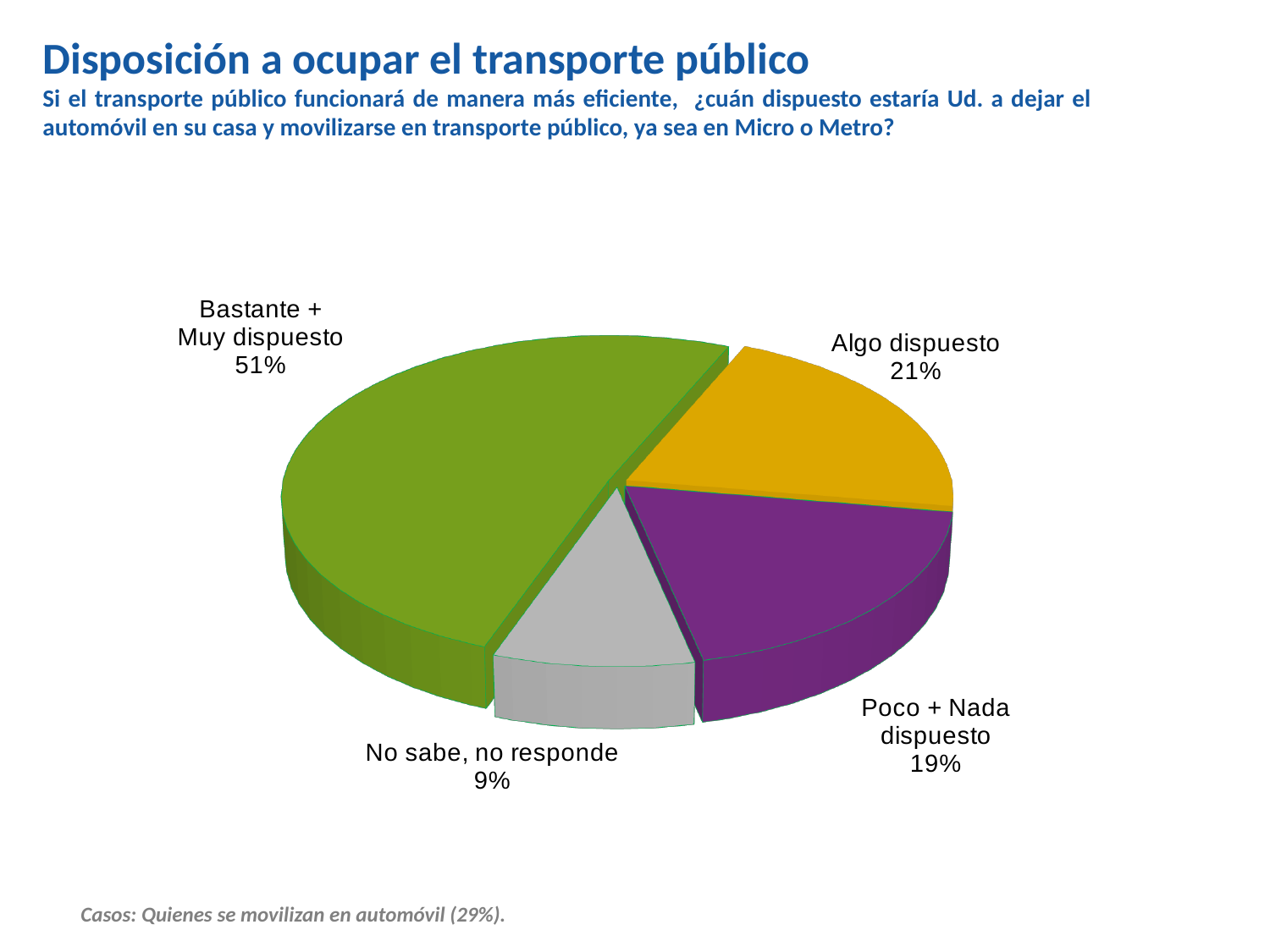
What is the difference in percentage points between "Bastante + Muy dispuesto" and "Algo dispuesto"? 30 Which is larger, "Algo dispuesto" or "Poco + Nada dispuesto"? Algo dispuesto What is the combined percentage of "Algo dispuesto" and "Poco + Nada dispuesto"? 40% What percentage is shown for "Bastante + Muy dispuesto"? 51% What percentage is shown for "No sabe, no responde"? 9% Which category has the largest share of the pie? Bastante + Muy dispuesto How many slices does the pie chart have? 4 Which category has the smallest share of the pie? No sabe, no responde What kind of chart is shown on the slide? pie chart What percentage is shown for "Poco + Nada dispuesto"? 19% What percentage is shown for "Algo dispuesto"? 21% What colour is the slice for "Bastante + Muy dispuesto"? green